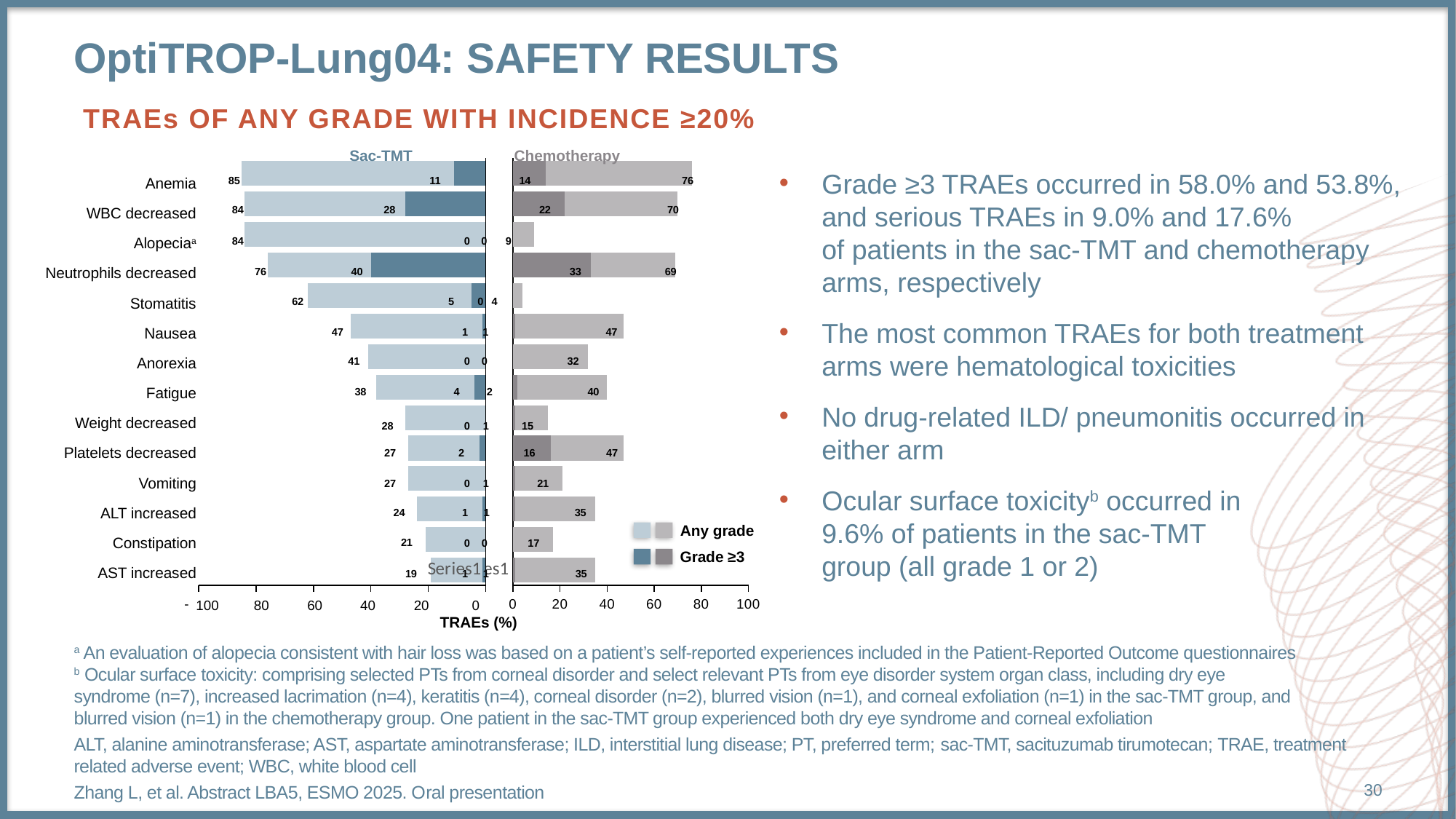
How many TRAE categories are listed on the chart? 14 Which TRAE has the highest any-grade incidence in the sac-TMT arm? Anemia Which TRAE has the lowest any-grade incidence in the chemotherapy arm? Stomatitis What is the any-grade incidence of alopecia in the chemotherapy arm? 9 Which arm has the higher grade ≥3 incidence of WBC decreased, sac-TMT or chemotherapy? Sac-TMT What is the difference between the any-grade incidence of stomatitis in the sac-TMT arm and in the chemotherapy arm? 58 Which arm has the higher any-grade incidence of platelets decreased, sac-TMT or chemotherapy? Chemotherapy What is the grade ≥3 incidence of neutrophils decreased in the chemotherapy arm? 33 What is the any-grade incidence of anemia in the sac-TMT arm? 85 How many series does the chart legend list? 2 What is the label of the x axis of the chart? TRAEs (%) What kind of chart is shown on the slide? Bar chart